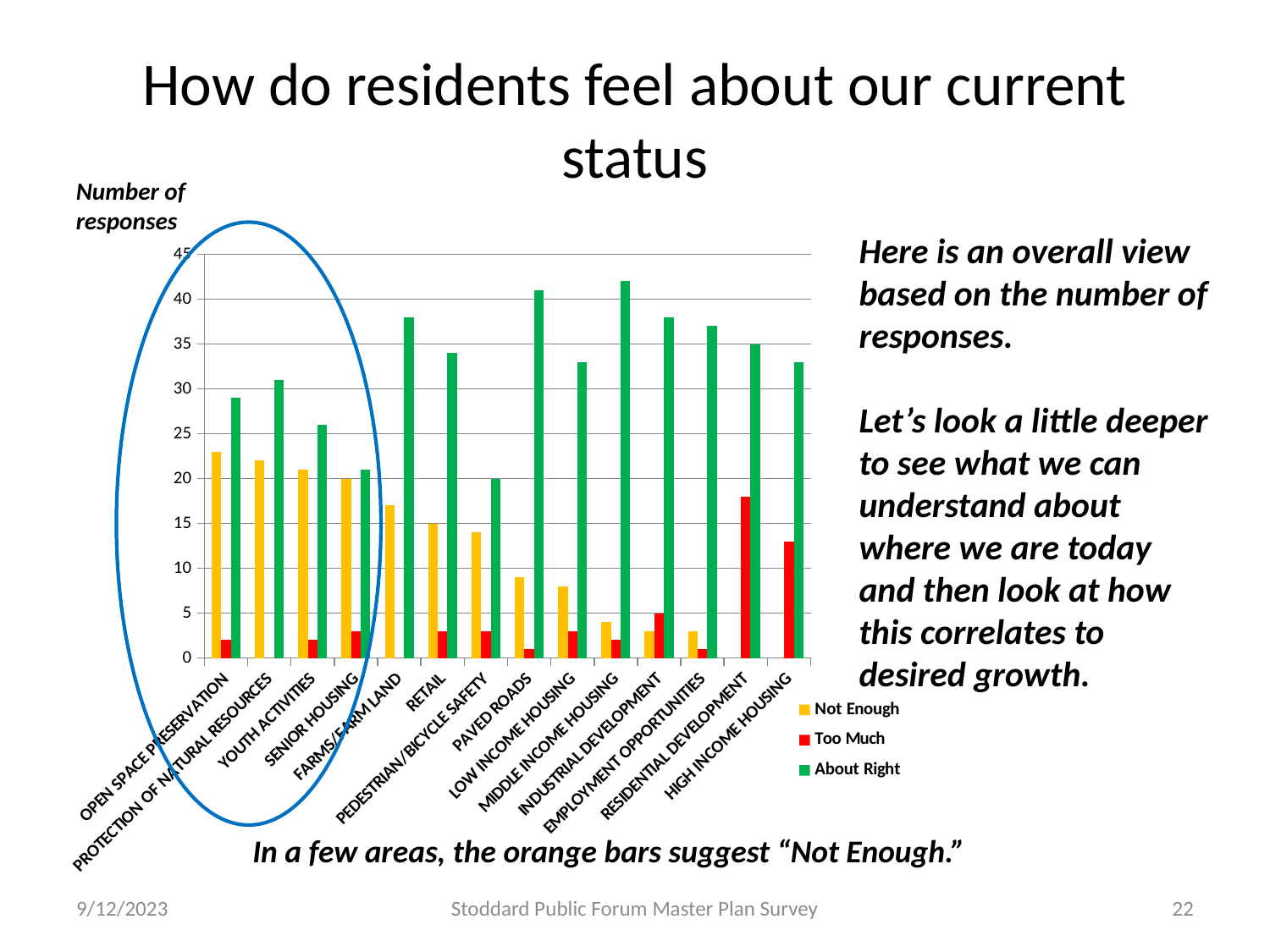
Which is larger: the 'Too Much' value for Residential Development or the 'Too Much' value for High Income Housing? Residential Development How many categories are shown along the x axis of the chart? 14 Which category has the highest 'Too Much' value? Residential Development For Open Space Preservation, which is larger: the 'Not Enough' value or the 'About Right' value? About Right Is the 'Too Much' value for Residential Development greater or less than 15? greater Is the 'Not Enough' value for Low Income Housing greater or less than 10? less Is the 'Not Enough' value for Open Space Preservation greater or less than 20? greater Do the 'Not Enough' values generally rise or fall moving left to right along the x axis? fall What colour represents the 'Too Much' series in the chart? red How many series does the chart legend list? 3 What kind of chart is shown on the slide? bar chart